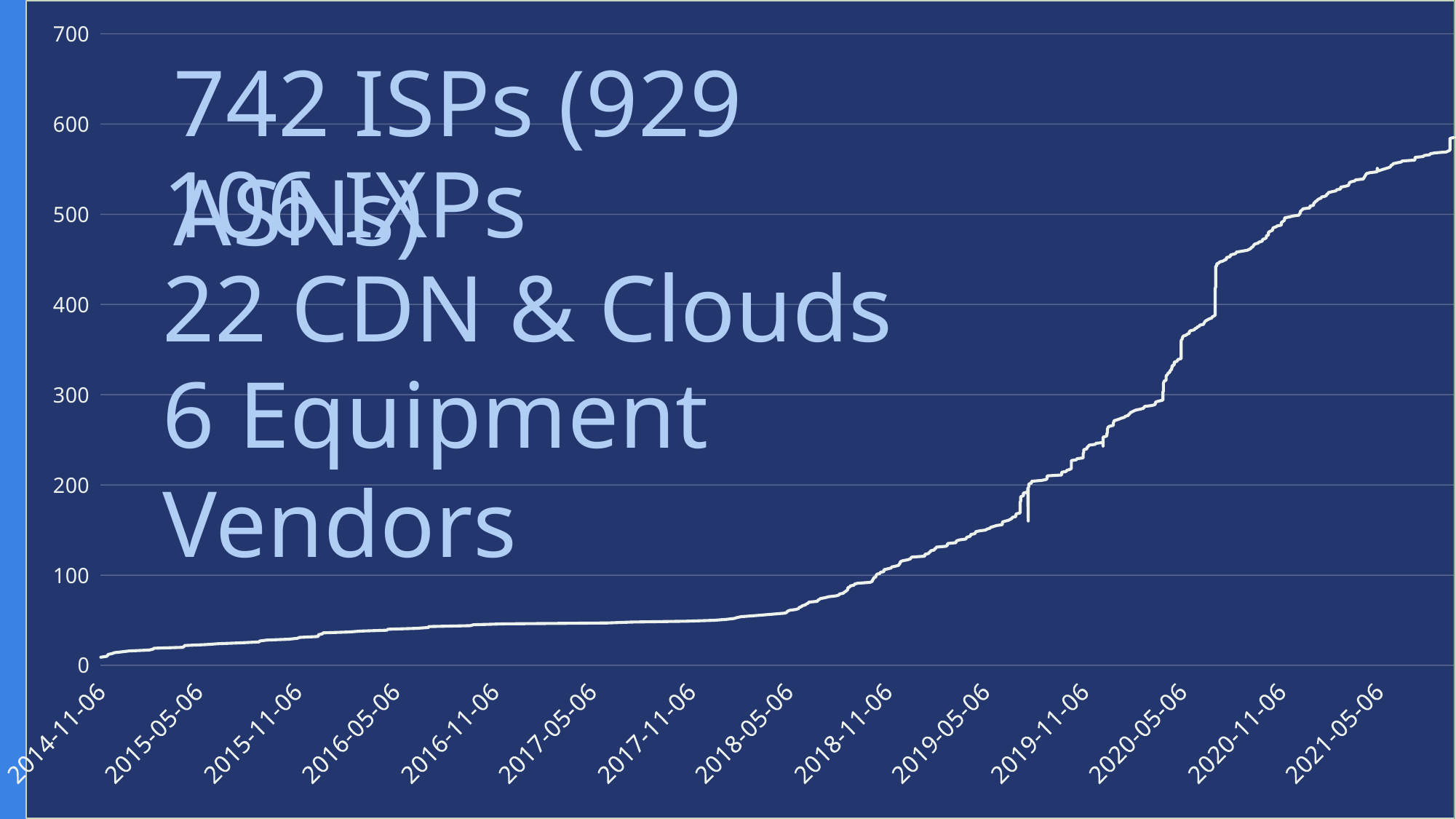
Is the value at 2021-05-06 greater or less than 500? greater Is the value at 2018-05-06 greater or less than 100? less Which date has the higher value, 2017-05-06 or 2020-05-06? 2020-05-06 Is the value at 2020-11-06 greater or less than 400? greater How many lines are plotted on the chart? 1 What is the highest value labelled on the y axis? 700 How many date labels are shown on the x axis? 14 Does the plotted line generally rise or fall from 2014-11-06 to 2021-05-06? rise What kind of chart is shown on the slide? line chart